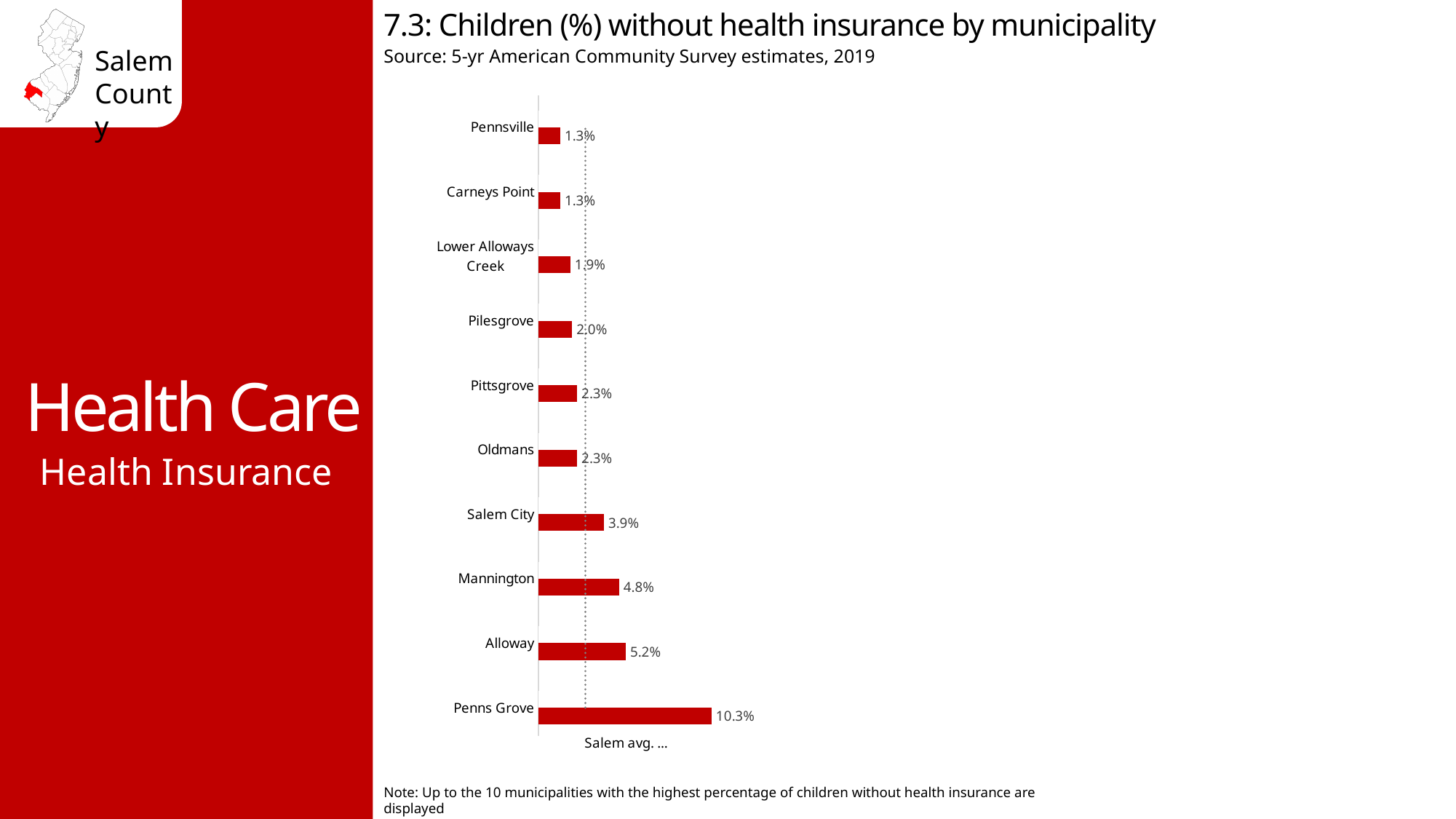
What is the value shown for Lower Alloways Creek? 1.9% What is the difference between the values for Salem City and Pittsgrove? 1.6% What is the difference between the values for Penns Grove and Alloway? 5.1% What is the value shown for Mannington? 4.8% Which municipality has the highest percentage of children without health insurance? Penns Grove What percentage of children in Penns Grove are without health insurance? 10.3% Which has a higher value, Pilesgrove or Alloway? Alloway Which has a higher value, Mannington or Salem City? Mannington What does the dotted vertical line in the chart represent? Salem avg. What is the title of the chart? 7.3: Children (%) without health insurance by municipality How many municipalities are shown in the chart? 10 What kind of chart is shown on the slide? Bar chart